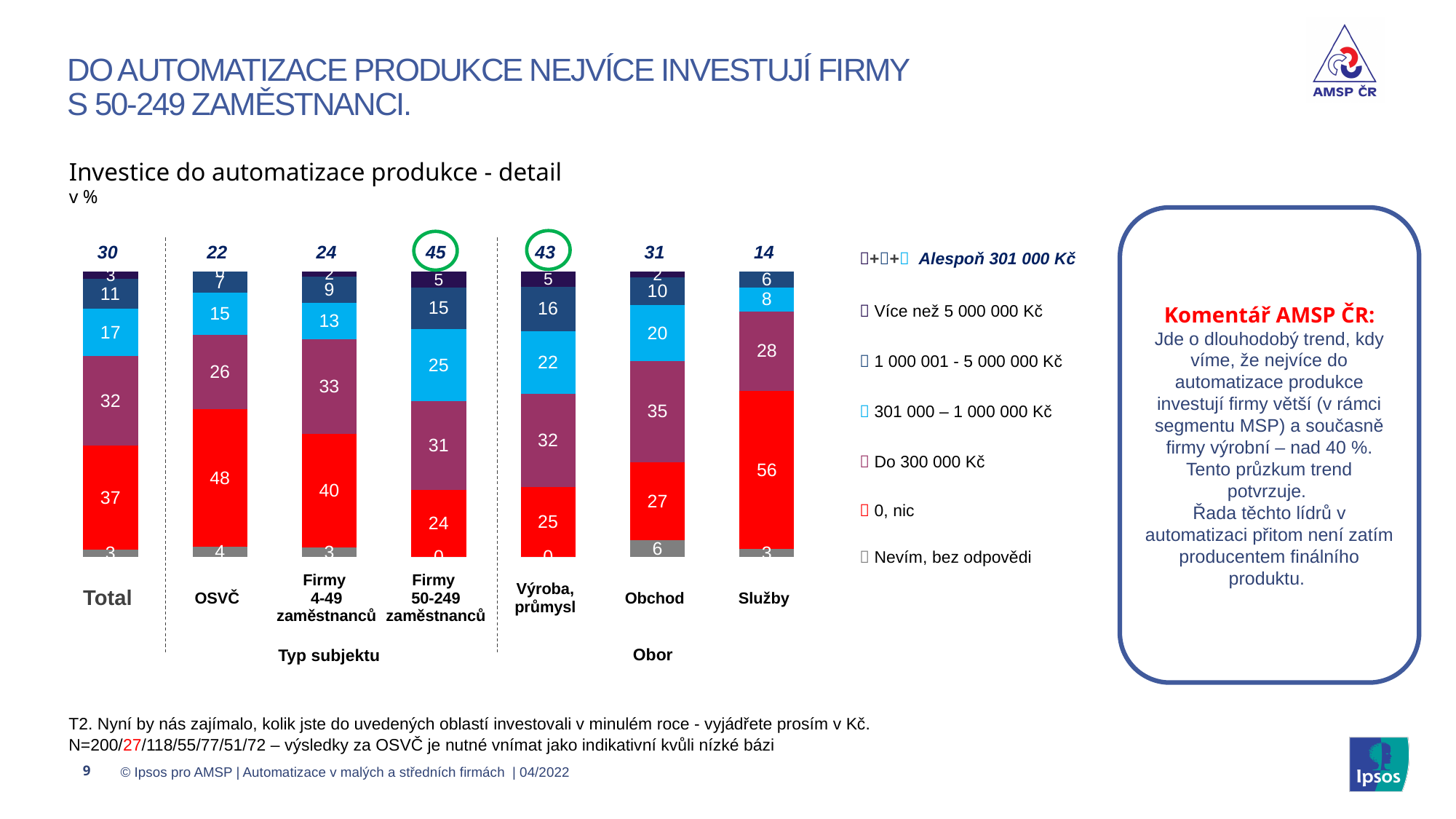
Which two categories have their "Alespoň 301 000 Kč" values circled in green? Firmy 50-249 zaměstnanců and Výroba, průmysl What is the difference between the "Alespoň 301 000 Kč" values for Firmy 50-249 zaměstnanců and Výroba, průmysl? 2 How many investment-level series does the legend list (excluding the "Alespoň 301 000 Kč" summary)? 6 Which has a larger "0, nic" value: OSVČ or Firmy 4-49 zaměstnanců? OSVČ What kind of chart is shown on the slide? Stacked bar chart Which category has the lowest "Alespoň 301 000 Kč" value shown above the bars? Služby What is the value of the "Do 300 000 Kč" segment for Obchod? 35 How many categories (bars) are shown in the chart? 7 What is the value of the "0, nic" segment for Služby? 56 Which category has the highest "Alespoň 301 000 Kč" value shown above the bars? Firmy 50-249 zaměstnanců What is the value of the "1 000 001 - 5 000 000 Kč" segment for Výroba, průmysl? 16 What is the value of the "301 000 – 1 000 000 Kč" segment for Firmy 50-249 zaměstnanců? 25